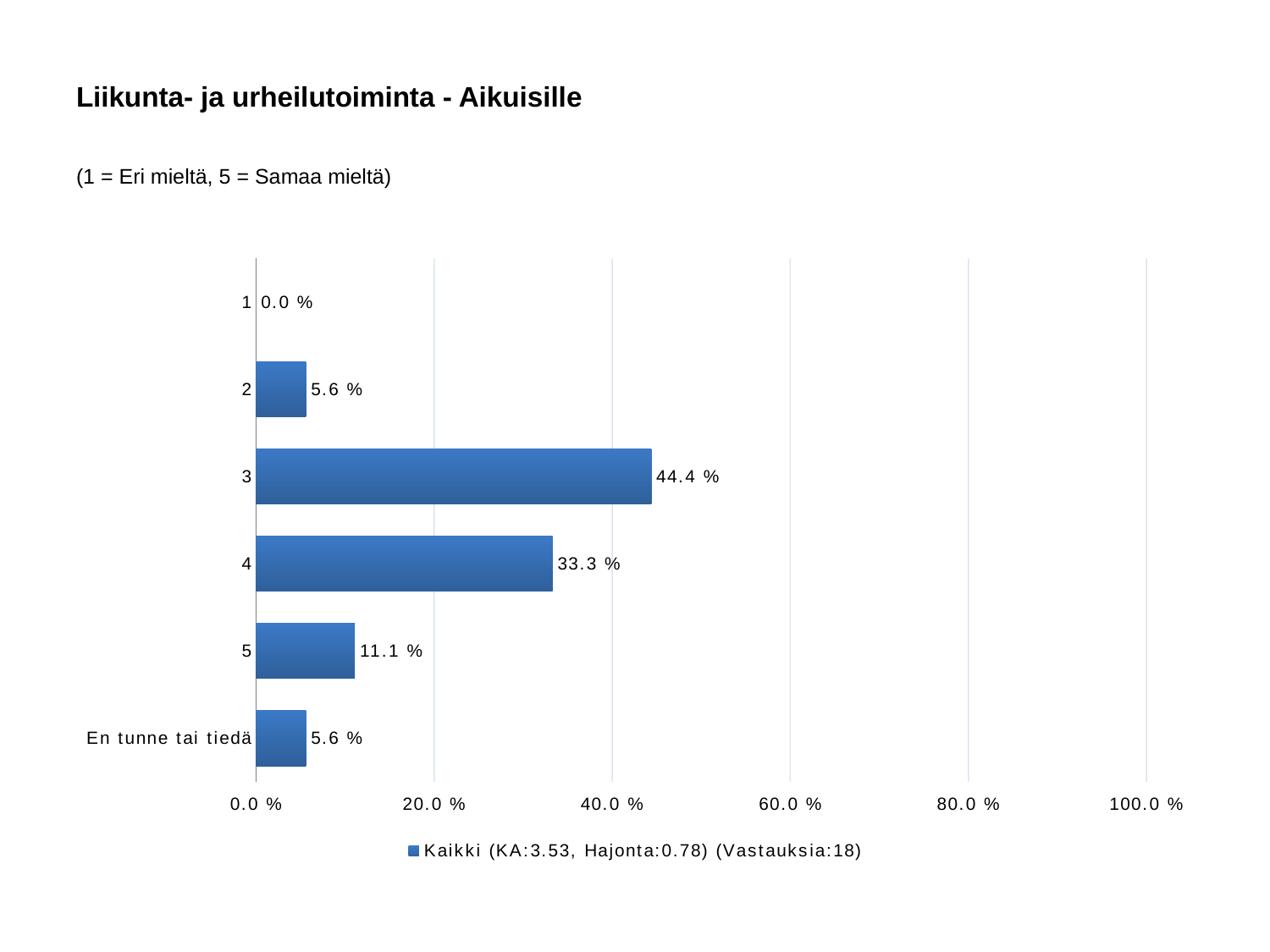
What kind of chart is shown on the slide? bar chart What is the value for category 1? 0.0 % What is the legend entry for the series? Kaikki (KA:3.53, Hajonta:0.78) (Vastauksia:18) What is the difference between the values for category 3 and category 4? 11.1 % What is the value for category 3? 44.4 % Which is larger, the value for category 4 or the value for category 5? 4 Is the value for category 3 greater or less than 40.0 %? greater How many categories are shown on the chart? 6 What is the value for 'En tunne tai tiedä'? 5.6 % Which category has the highest value? 3 Which category has the lowest value? 1 What is the value for category 5? 11.1 %